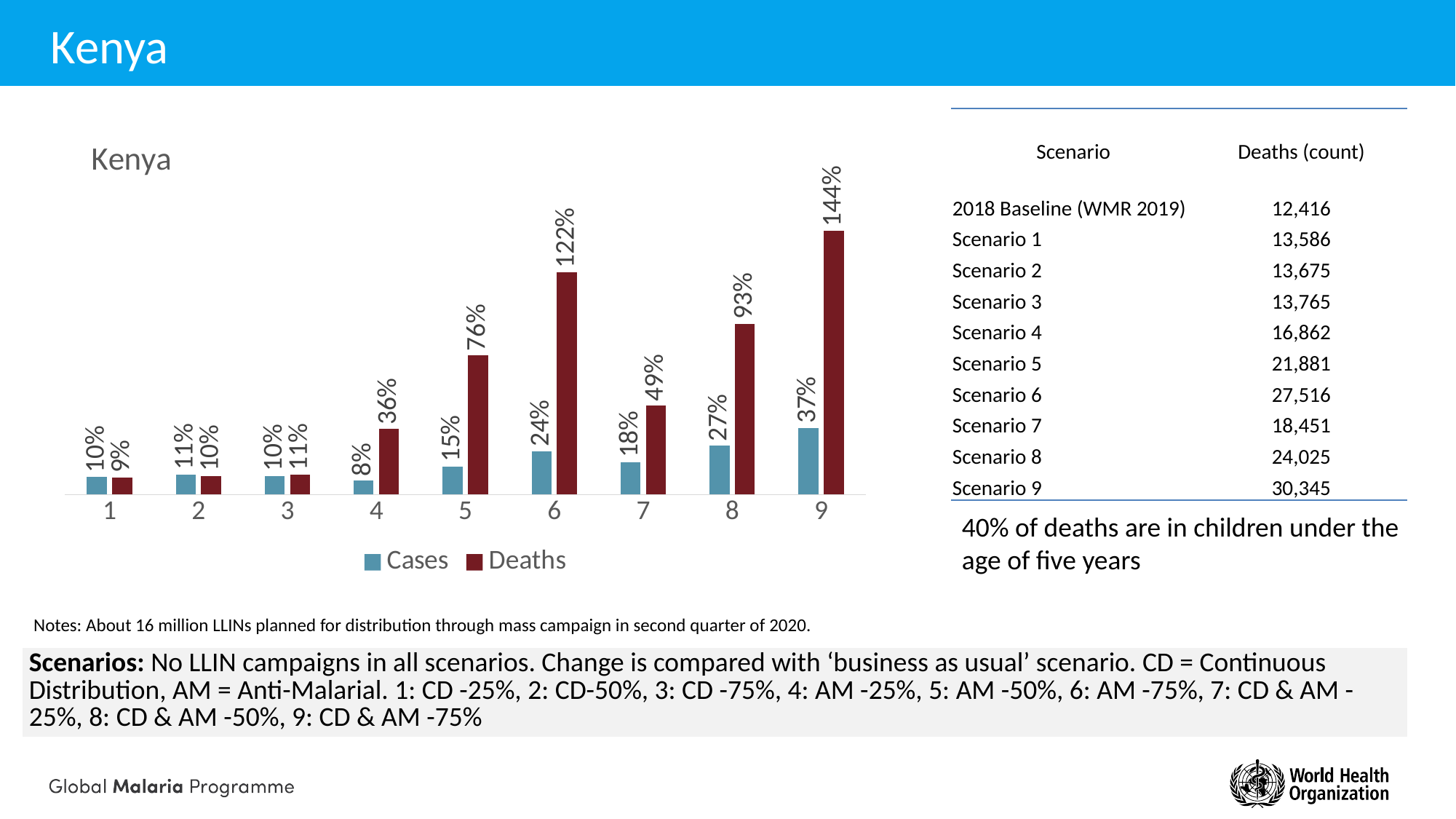
What is the Cases value for scenario 6? 24% Which scenario has the highest Deaths value? 9 What is the Deaths value for scenario 4? 36% How many scenarios are shown on the x axis of the chart? 9 Which is larger for scenario 8, the Cases value or the Deaths value? Deaths What is the Deaths value for scenario 9? 144% What kind of chart is shown on the slide? bar chart How many series does the chart legend list? 2 Which scenario has the lowest Cases value? 4 What are the two series named in the chart legend? Cases and Deaths Do the Cases values rise or fall from scenario 7 to scenario 9? rise What is the difference between the Deaths value and the Cases value for scenario 6? 98%